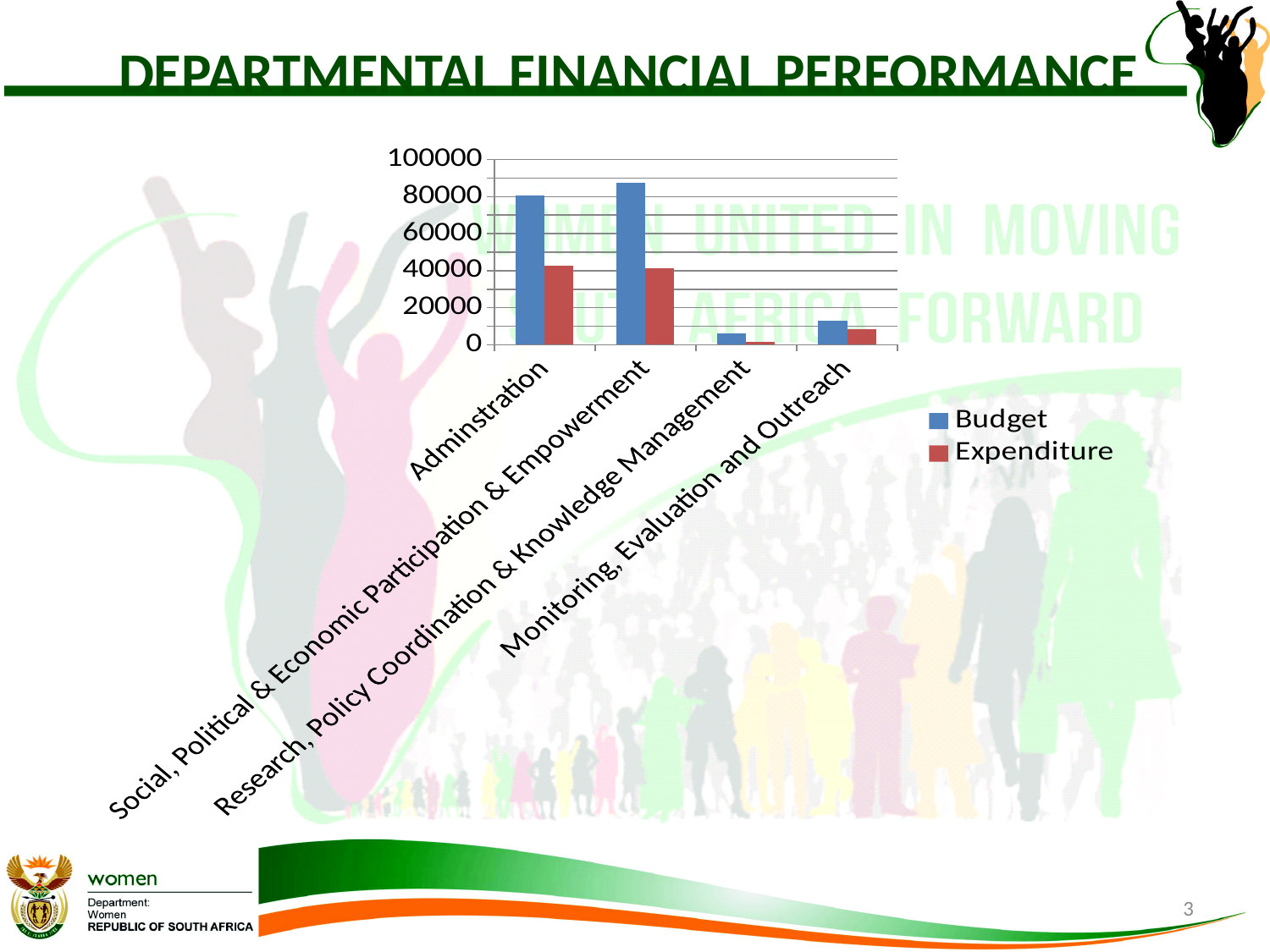
Which category has the highest Budget value? Social, Political & Economic Participation & Empowerment Is the Budget value for Adminstration greater or less than 60000? greater Is the Budget value for Monitoring, Evaluation and Outreach greater or less than 20000? less Which category has the lowest Expenditure value? Research, Policy Coordination & Knowledge Management Which series is shown in red in the chart's legend? Expenditure How many series does the chart's legend list? 2 For Adminstration, which is larger: Budget or Expenditure? Budget Is the Budget value for Social, Political & Economic Participation & Empowerment greater or less than 80000? greater Which category has the lowest Budget value? Research, Policy Coordination & Knowledge Management How many categories are shown on the x axis of the chart? 4 What kind of chart is shown on the slide? bar chart